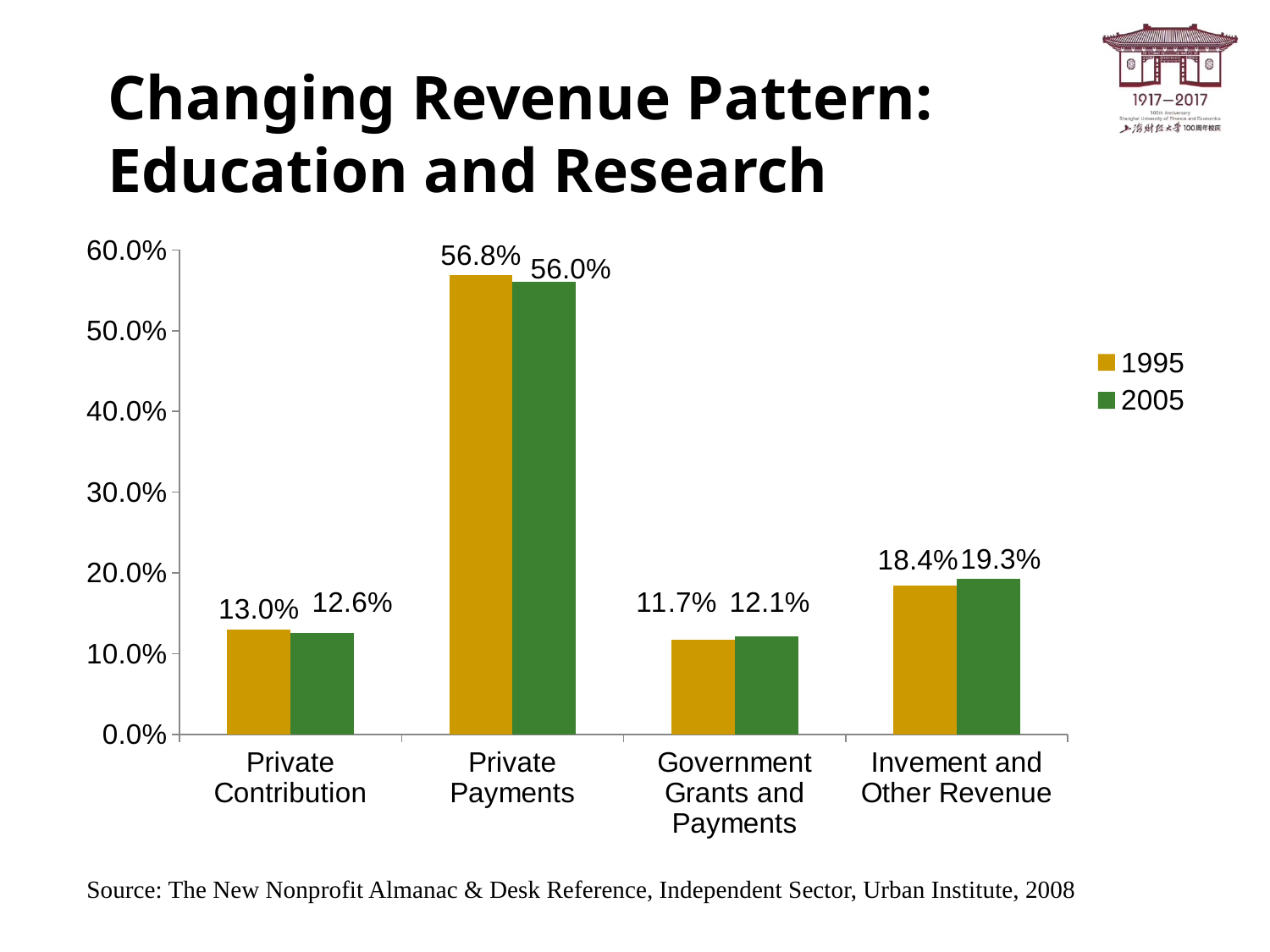
Which category has the highest value for 1995? Private Payments What is the 2005 value for Invement and Other Revenue? 19.3% What is the difference between the 1995 and 2005 values for Private Payments? 0.8% What is the difference between the 2005 and 1995 values for Invement and Other Revenue? 0.9% What is the 1995 value for Private Payments? 56.8% What kind of chart is shown on the slide? Bar chart How many categories are shown on the x axis? 4 Which category has the lowest value for 2005? Government Grants and Payments What is the 2005 value for Government Grants and Payments? 12.1% Is the 2005 value for Private Payments greater or less than 50.0%? greater For Private Contribution, which year has the larger value, 1995 or 2005? 1995 How many series does the legend list? 2